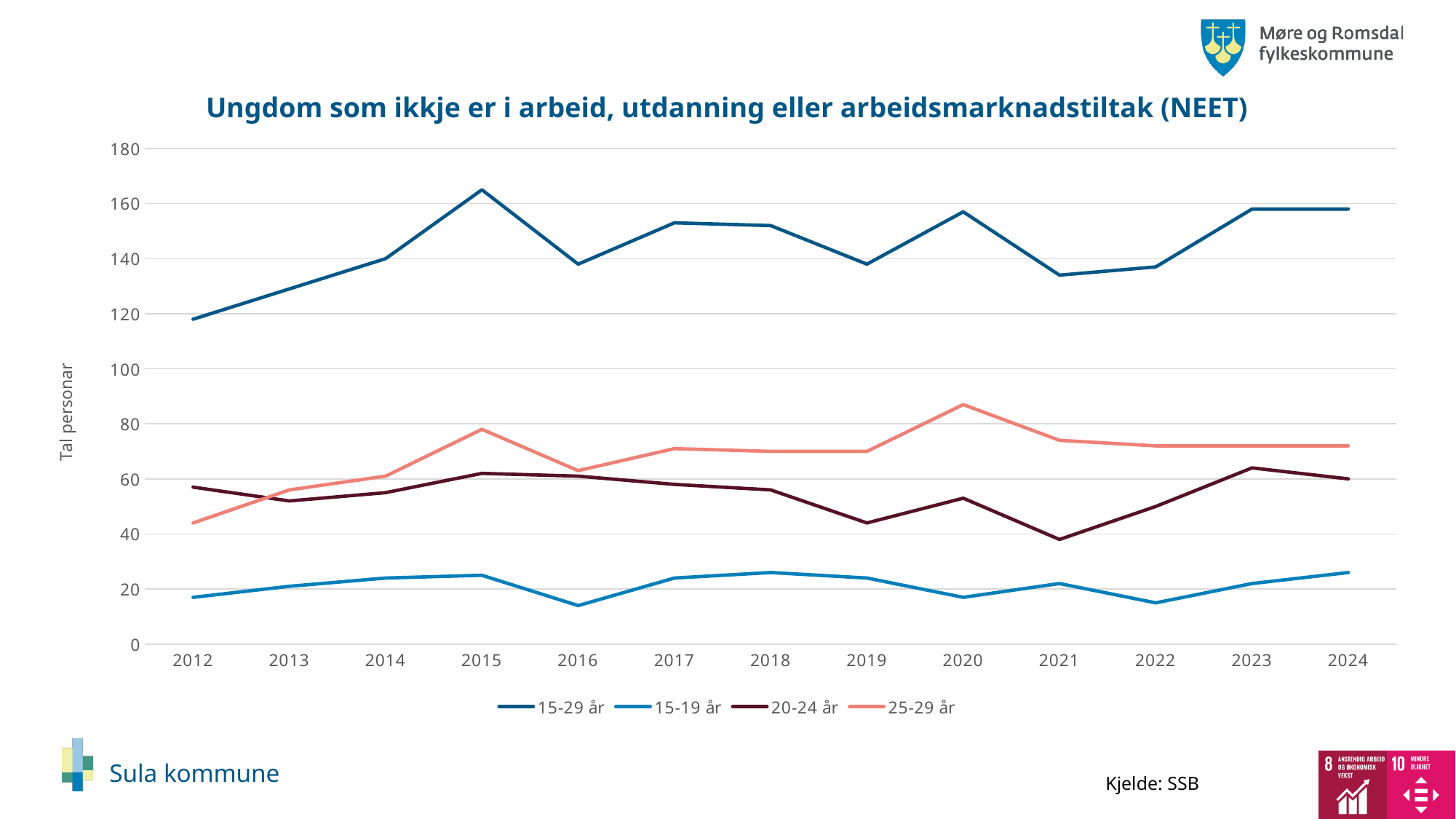
How many series does the legend list? 4 Is the value for 15-29 år in 2015 greater or less than 160? greater How many years are shown on the x axis? 13 Does the 15-29 år series rise or fall from 2021 to 2024? rise In which year does the 25-29 år series reach its highest value? 2020 In which year does the 15-29 år series reach its highest value? 2015 What kind of chart is shown on the slide? line chart Is the value for 20-24 år in 2021 greater or less than 40? less In which year does the 15-29 år series have its lowest value? 2012 In which year does the 20-24 år series have its lowest value? 2021 In 2012, which series has the larger value: 20-24 år or 25-29 år? 20-24 år Is the value for 25-29 år in 2020 greater or less than 80? greater